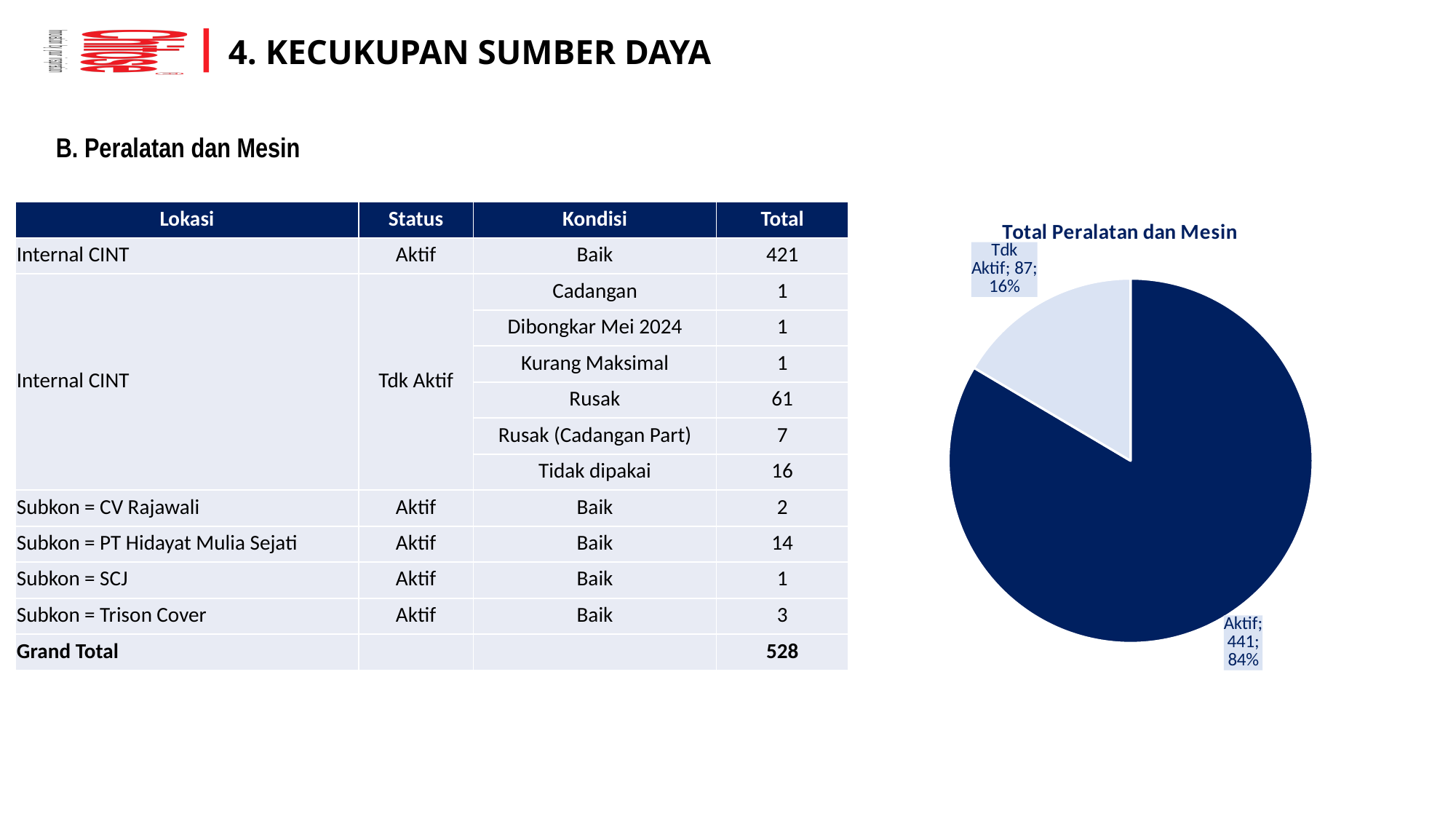
What is the value for Aktif in the pie chart? 441 What kind of chart is shown on the slide? pie chart What share of the pie does Aktif represent? 84% What is the title of the chart? Total Peralatan dan Mesin How many slices does the pie chart have? 2 Which slice of the pie chart is the largest? Aktif What is the difference between the Aktif and Tdk Aktif values in the pie chart? 354 What share of the pie does Tdk Aktif represent? 16% Which slice of the pie chart is the smallest? Tdk Aktif What is the total of the two slices in the pie chart? 528 What is the value for Tdk Aktif in the pie chart? 87 Which is larger in the pie chart, Aktif or Tdk Aktif? Aktif